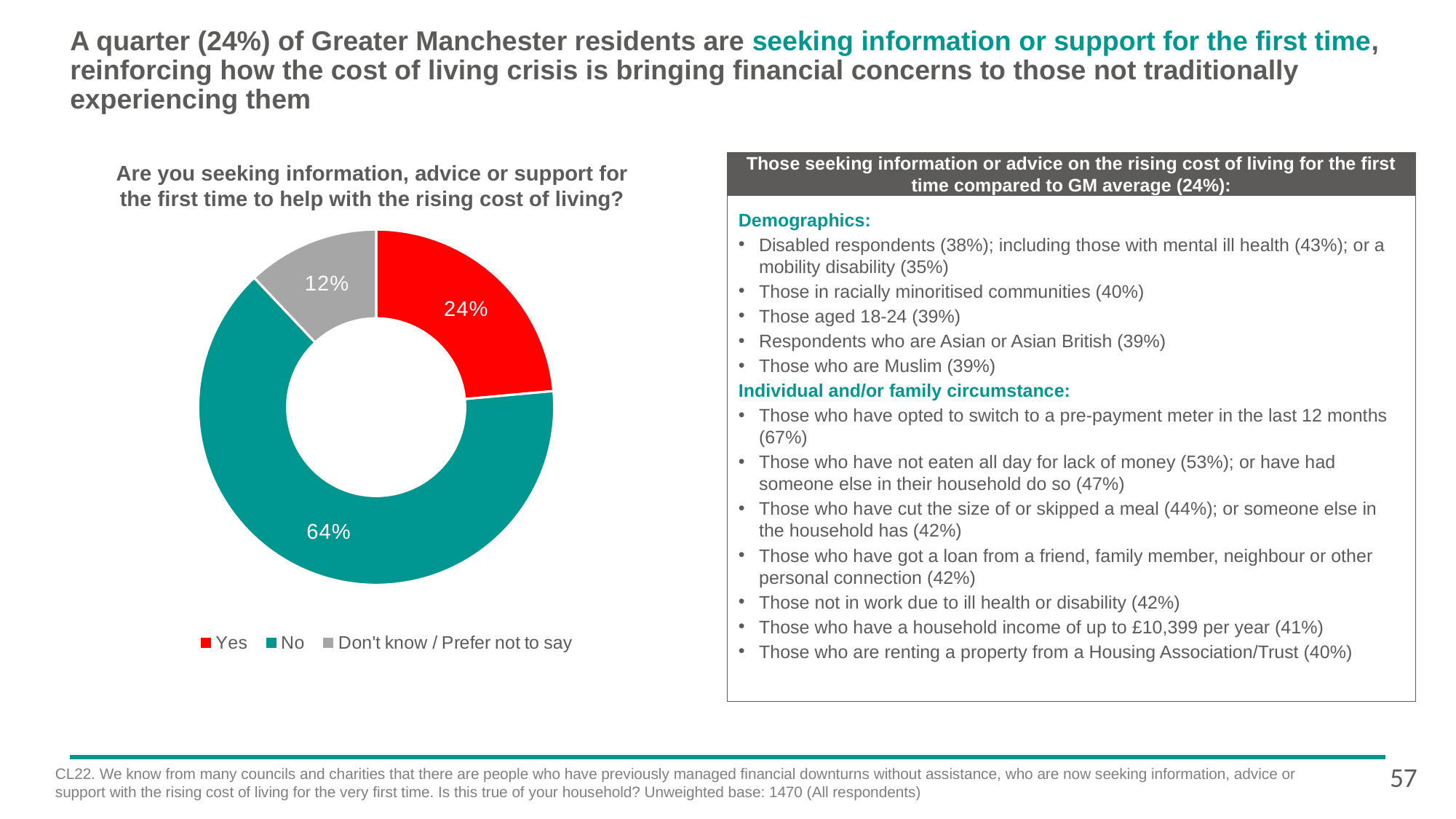
What is the combined share of 'Yes' and 'Don't know / Prefer not to say' responses? 36% Which is larger, the share for 'Yes' or the share for 'Don't know / Prefer not to say'? Yes What type of chart is used to show the responses? Pie chart (doughnut) What percentage of respondents answered 'Don't know / Prefer not to say'? 12% What is the title of the chart? Are you seeking information, advice or support for the first time to help with the rising cost of living? What colour represents the 'No' response in the chart? Teal What percentage of respondents answered 'Yes' to seeking information, advice or support for the first time? 24% Which response has the largest share of the chart? No How many categories are shown in the chart? 3 Which response has the smallest share of the chart? Don't know / Prefer not to say What is the difference in percentage points between the 'No' and 'Yes' responses? 40 What percentage of respondents answered 'No'? 64%